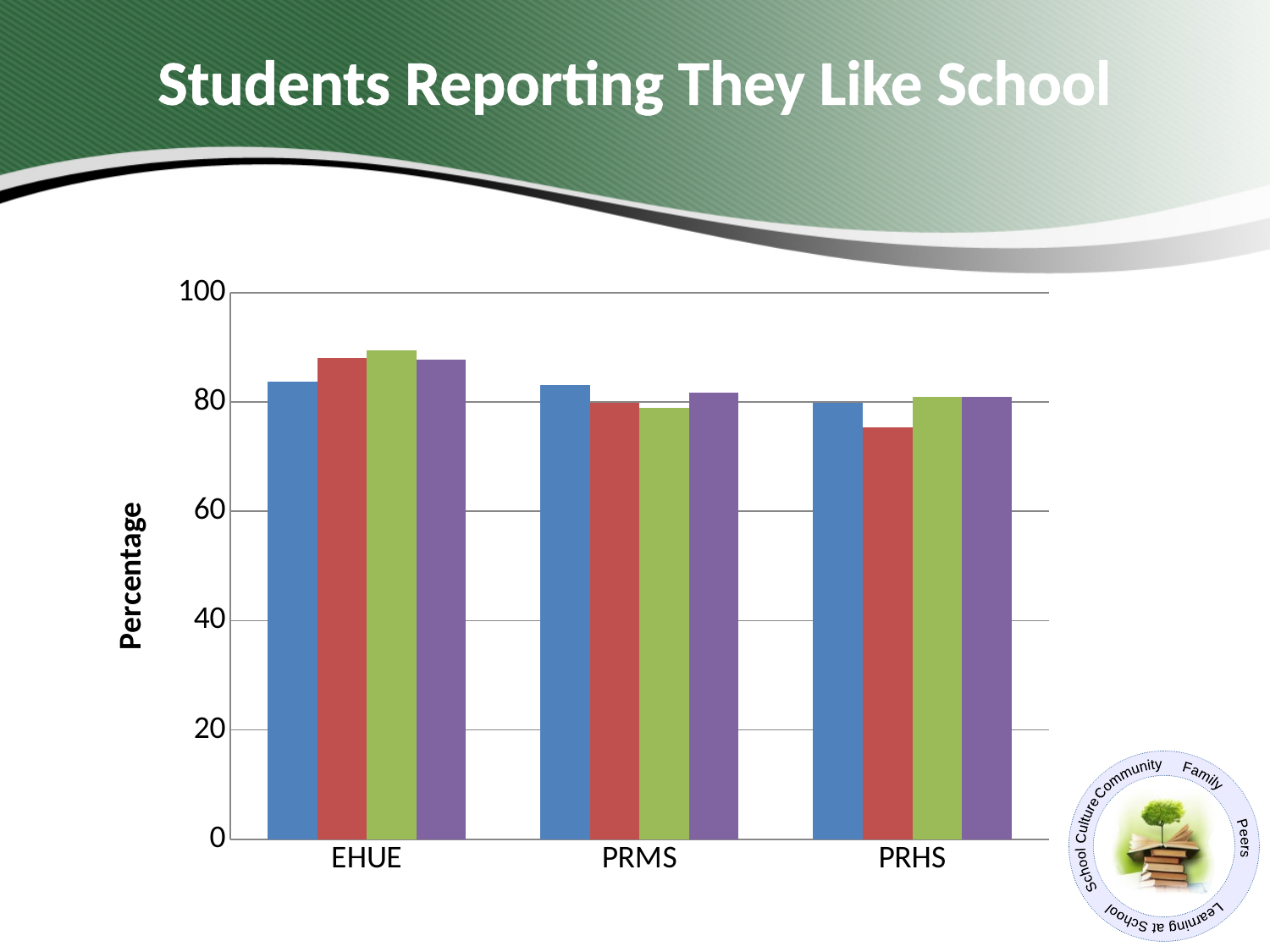
How many bars are plotted for each category in the chart? 4 Is the value of the green bar for EHUE greater or less than 80? greater Is the value of the blue bar for PRMS greater or less than 60? greater What is the label on the vertical axis of the chart? Percentage What is the title of the chart? Students Reporting They Like School What kind of chart is shown on the slide? bar chart Is the value of the blue bar for EHUE greater or less than 80? greater Which bar is the lowest within the PRHS category? the red bar How many categories are shown on the x axis of the chart? 3 Within the EHUE category, which is larger: the blue bar or the red bar? the red bar Within the PRHS category, which is larger: the red bar or the green bar? the green bar